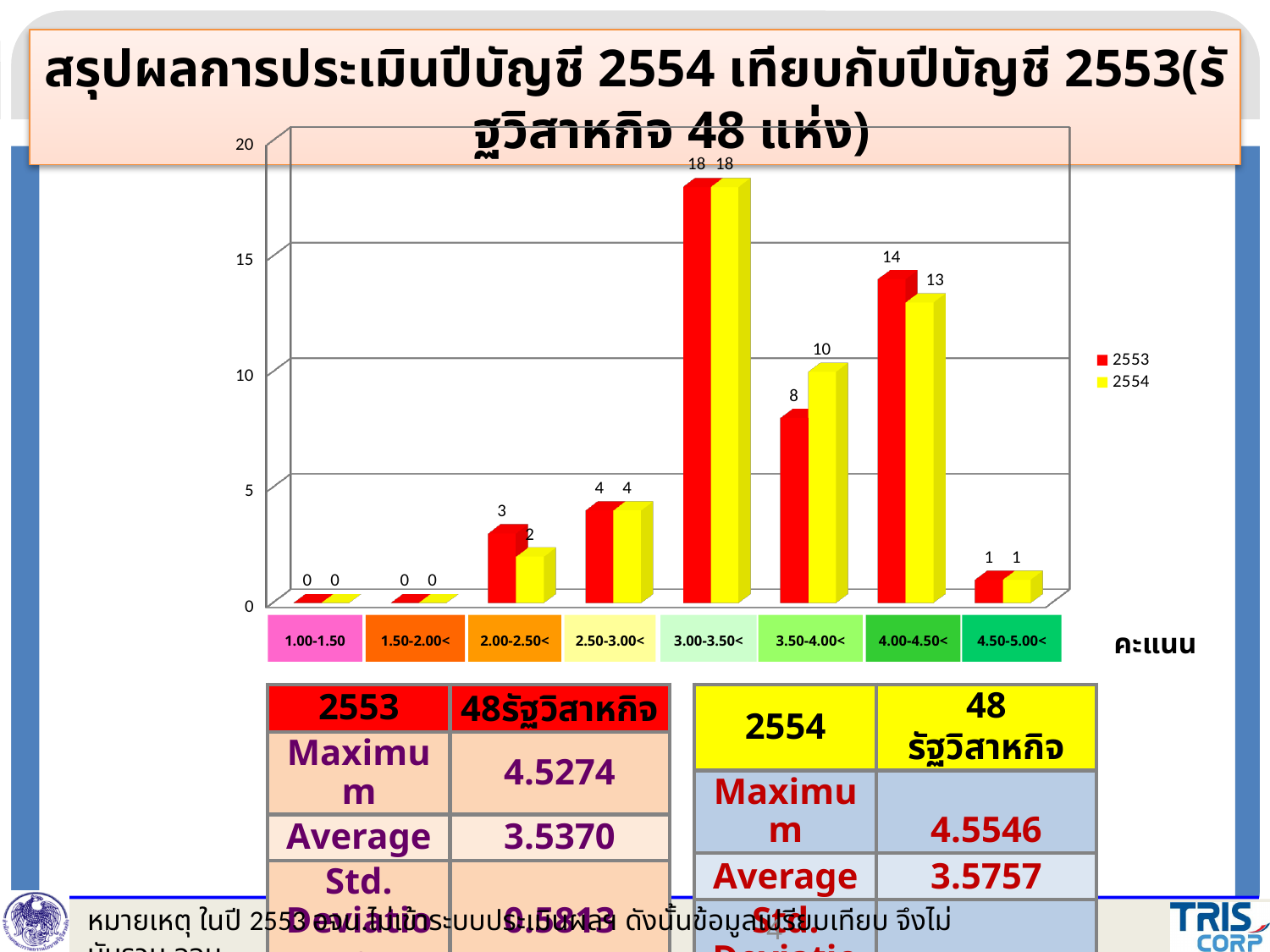
What is the difference between the 2553 values for 3.00-3.50< and 4.00-4.50<? 4 What is the value for 2554 in the 2.00-2.50< category? 2 In the 4.00-4.50< category, which series has the larger value, 2553 or 2554? 2553 How many categories are shown on the x axis of the chart? 8 Which category has the highest value for the 2554 series? 3.00-3.50< What is the value for 2553 in the 4.00-4.50< category? 14 What kind of chart is shown on the slide? bar chart What is the value for 2554 in the 3.50-4.00< category? 10 What is the difference between the 2553 and 2554 values in the 3.50-4.00< category? 2 Is the value for 2553 in the 3.50-4.00< category greater or less than 10? less How many series does the chart legend list? 2 What is the value for 2553 in the 3.00-3.50< category? 18